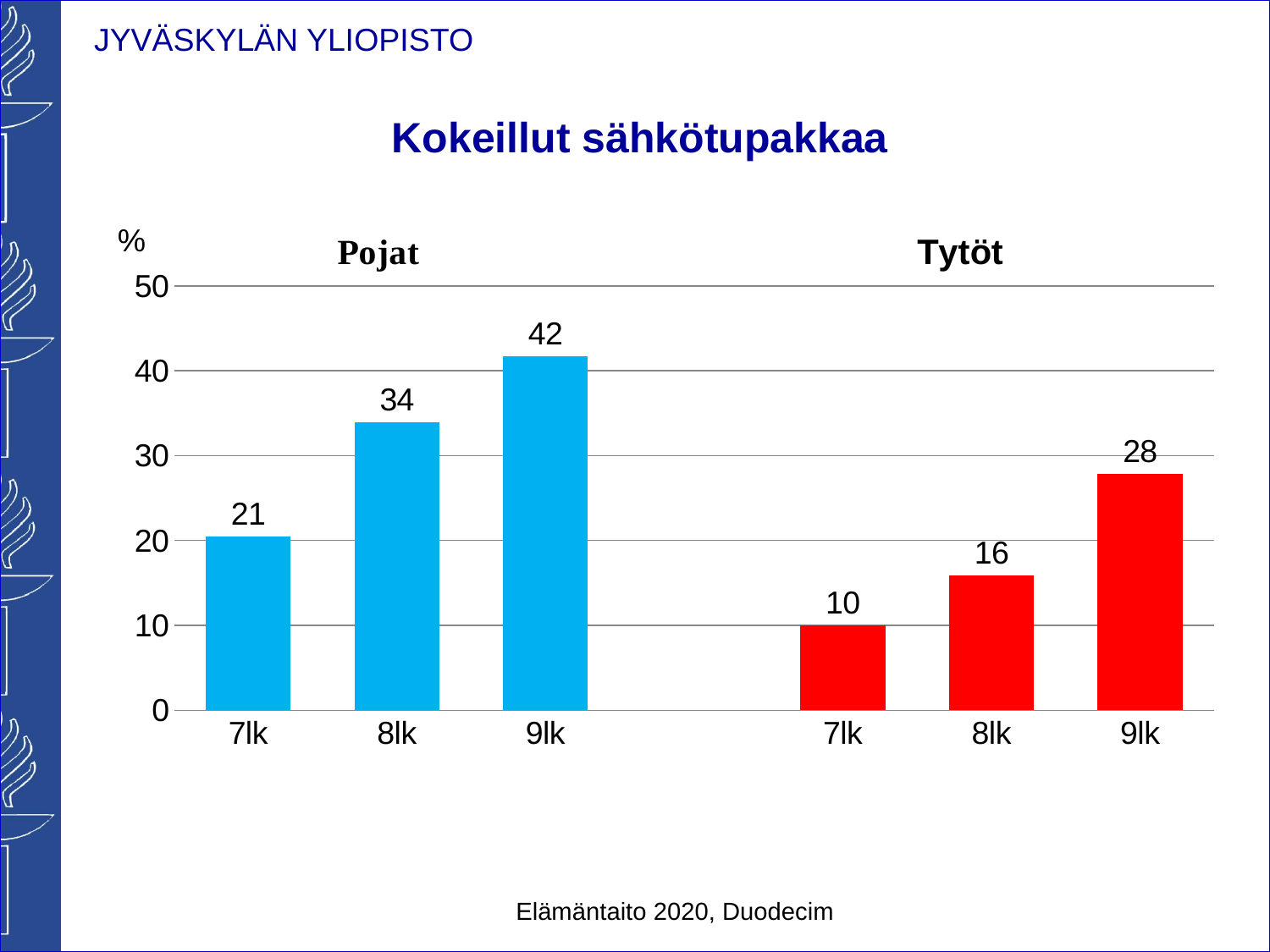
What is the value for 9lk in the Pojat group? 42 What is the value for 8lk in the Pojat group? 34 How many bars are plotted on the chart in total? 6 What is the title of the chart? Kokeillut sähkötupakkaa What is the difference between the Pojat 9lk value and the Tytöt 9lk value? 14 What kind of chart is shown on the slide? bar chart Which is larger, the Pojat 7lk value or the Tytöt 8lk value? Pojat 7lk What is the difference between the Pojat 8lk and Pojat 7lk values? 13 Do the values for Tytöt rise or fall from 7lk to 9lk? rise Which bar has the highest value on the chart? Pojat 9lk What is the value for 7lk in the Tytöt group? 10 Which bar has the lowest value on the chart? Tytöt 7lk